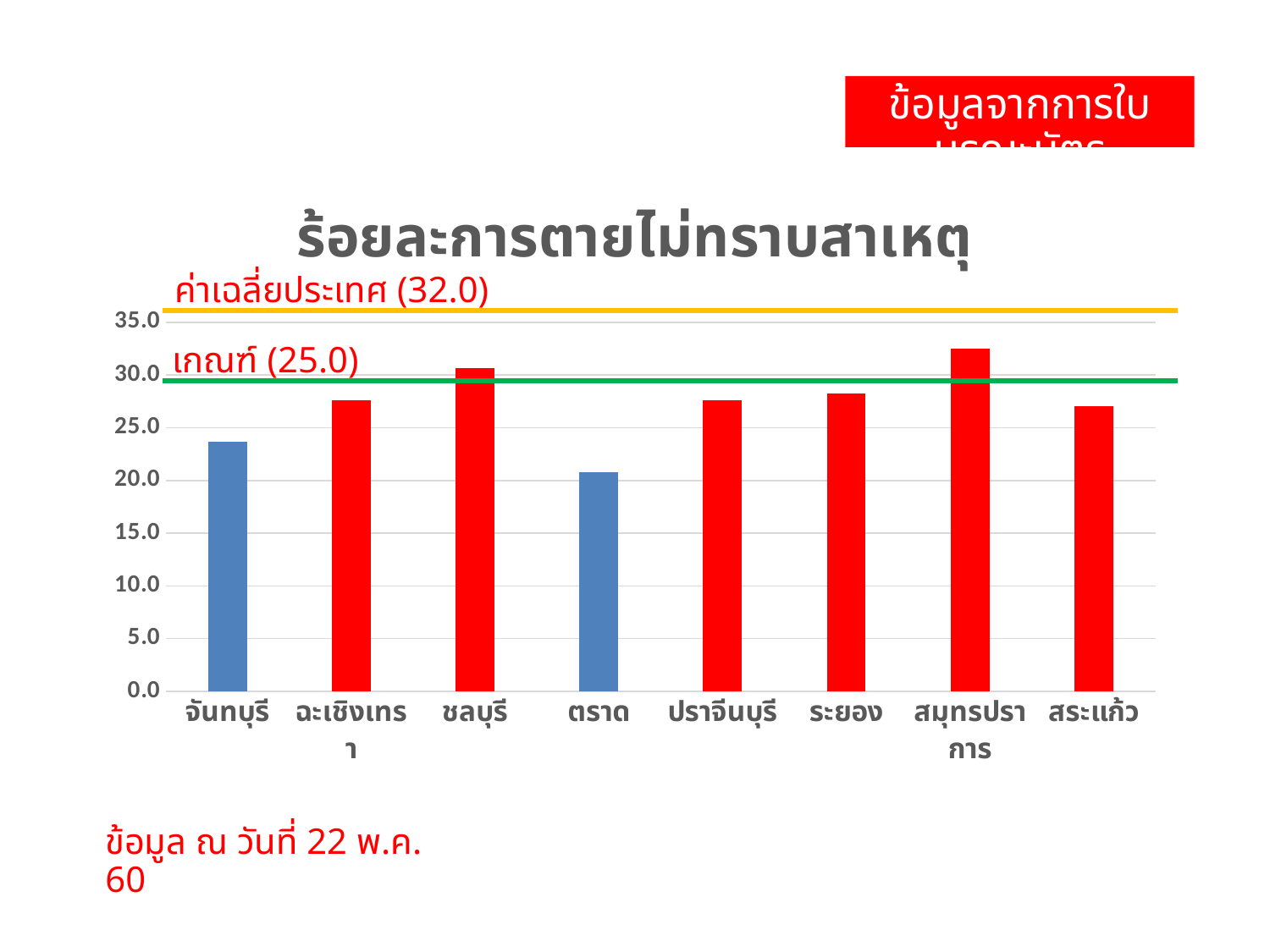
What type of chart is shown on the slide? bar chart Which is larger, the value for ชลบุรี or the value for ตราด? ชลบุรี Is the value for จันทบุรี greater or less than 25.0? less Which province has the lowest bar in the chart? ตราด Is the value for สมุทรปราการ greater or less than 30.0? greater What is the title of the chart? ร้อยละการตายไม่ทราบสาเหตุ How many provinces (categories) are shown on the x axis of the chart? 8 What value is given for the national average line (ค่าเฉลี่ยประเทศ) on the chart? 32.0 Is the value for ฉะเชิงเทรา greater or less than 25.0? greater Which province has the highest bar in the chart? สมุทรปราการ Which is larger, the value for สมุทรปราการ or the value for จันทบุรี? สมุทรปราการ